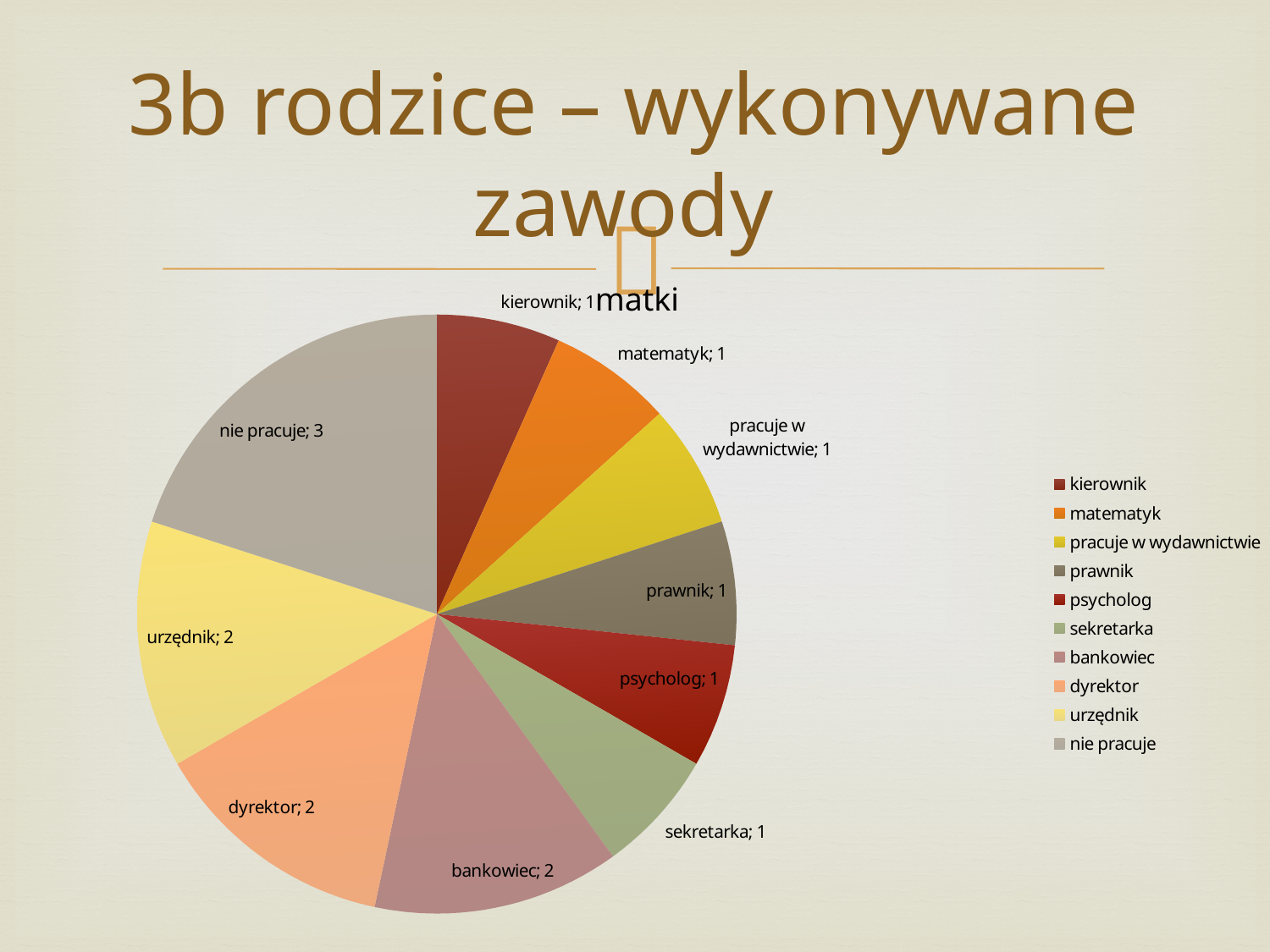
What is the difference between the values for 'nie pracuje' and 'dyrektor'? 1 What is the value for 'psycholog'? 1 Which category has the largest slice of the pie? nie pracuje What kind of chart is shown on the slide? pie chart What is the value for 'bankowiec'? 2 How many categories does the pie chart have? 10 Which is larger, the value for 'urzędnik' or the value for 'prawnik'? urzędnik What is the value for 'nie pracuje'? 3 What is the title of the pie chart? matki What share of the pie does 'nie pracuje' represent? 20% How many entries does the legend list? 10 What is the total of all the values in the pie chart? 15